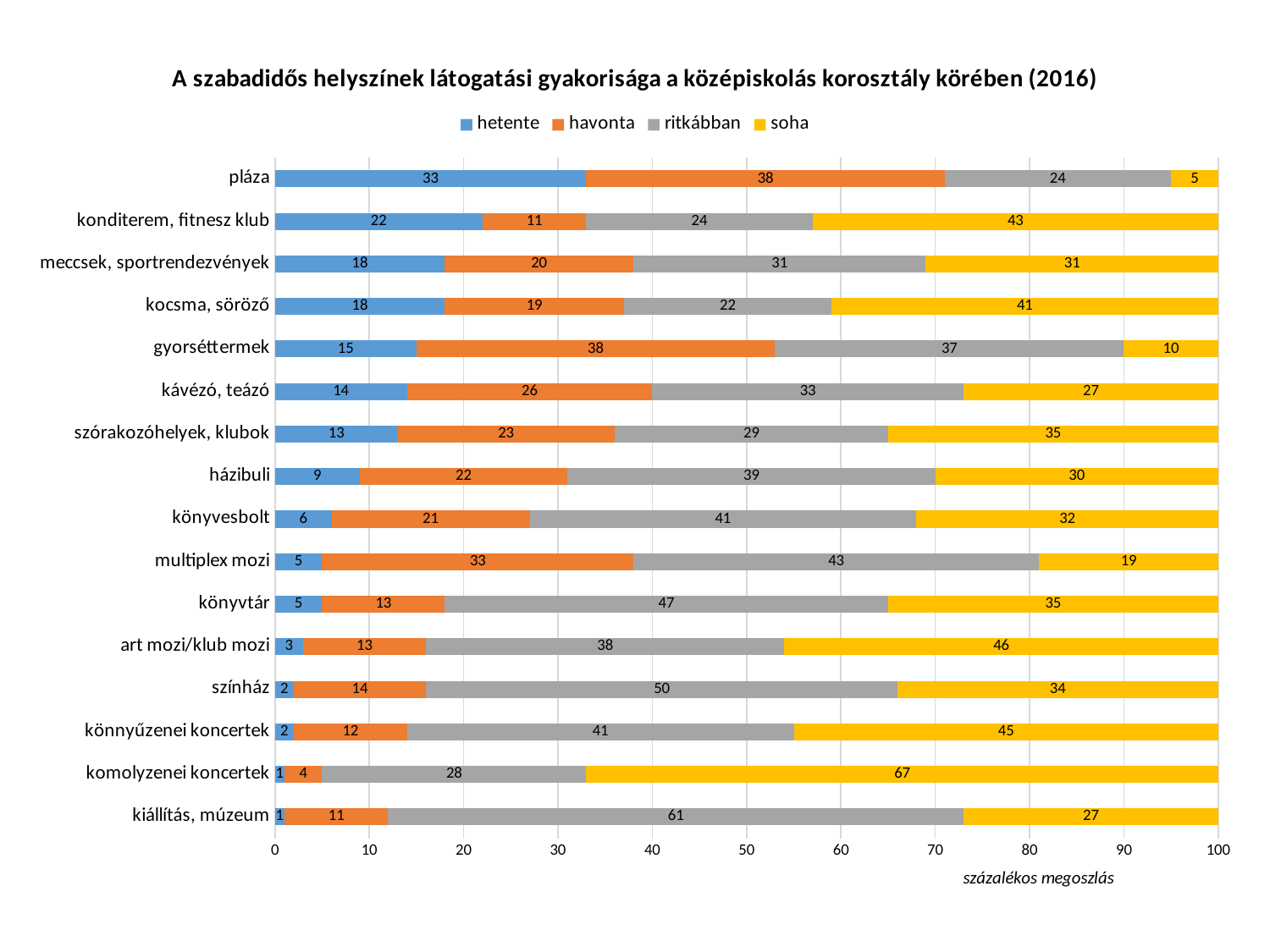
Which is larger: the 'hetente' value for házibuli or the 'hetente' value for könyvesbolt? házibuli Which category has the highest 'ritkábban' value? kiállítás, múzeum Which category has the highest 'soha' value? komolyzenei koncertek What is the difference between the 'havonta' values for gyorséttermek and kocsma, söröző? 19 Which category has the lowest 'soha' value? pláza What type of chart is shown on the slide? stacked bar chart What is the 'hetente' value for pláza? 33 What is the total of the stacked bar for kocsma, söröző? 100 What is the 'soha' value for konditerem, fitnesz klub? 43 What is the 'ritkábban' value for színház? 50 How many series does the legend list? 4 How many categories (venues) are shown on the chart? 16